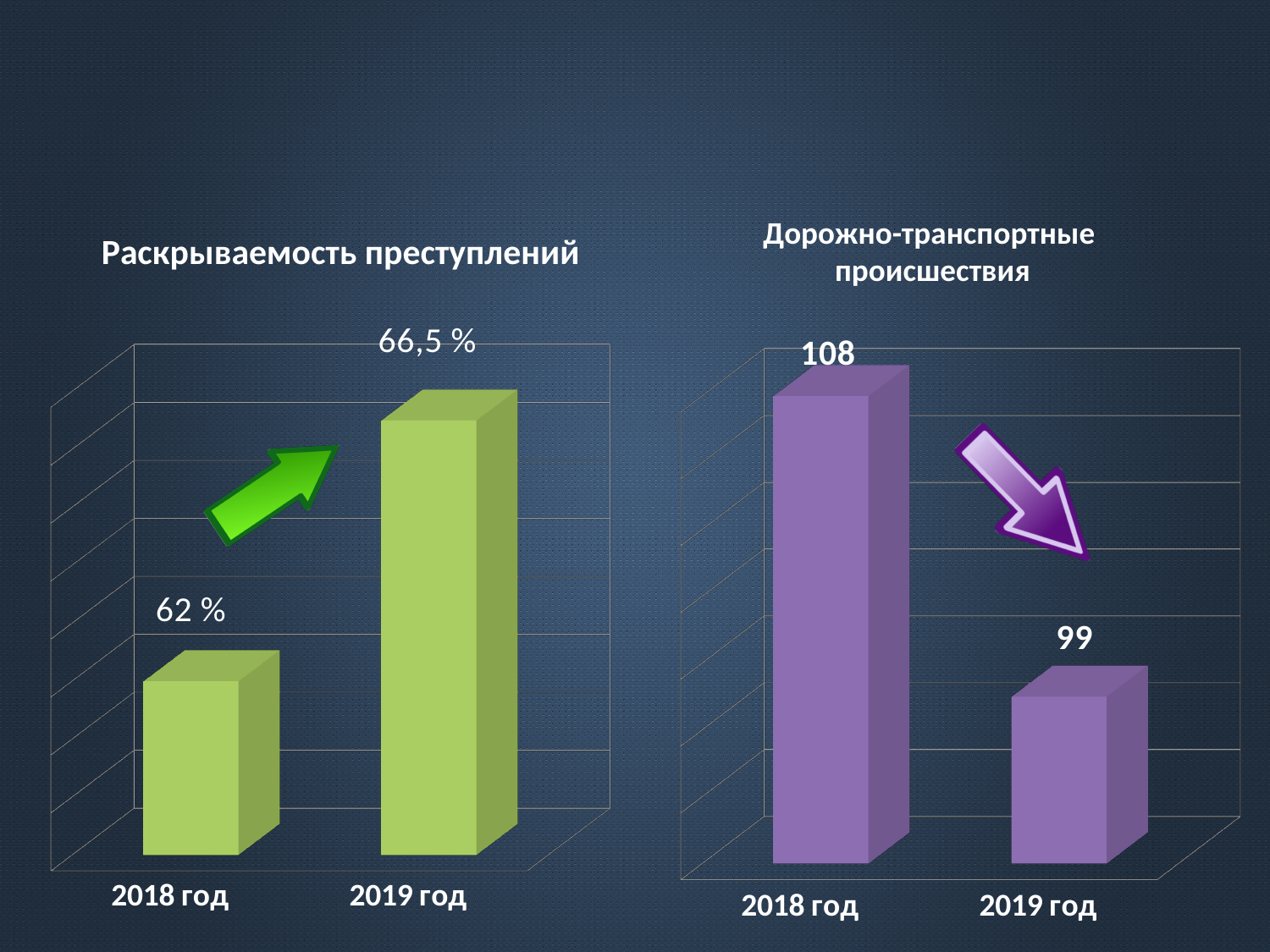
In the chart titled "Дорожно-транспортные происшествия", what is the value for 2018 год? 108 In the chart titled "Дорожно-транспортные происшествия", what is the value for 2019 год? 99 What kind of chart is the chart titled "Дорожно-транспортные происшествия"? bar chart In the chart titled "Дорожно-транспортные происшествия", is the value for 2018 год larger or smaller than the value for 2019 год? larger How many categories are shown in the chart titled "Раскрываемость преступлений"? 2 In the chart titled "Раскрываемость преступлений", what is the value for 2018 год? 62 % In the chart titled "Дорожно-транспортные происшествия", what is the difference between the 2018 год and 2019 год values? 9 In the chart titled "Дорожно-транспортные происшествия", which year has the lower value? 2019 год In the chart titled "Дорожно-транспортные происшествия", do the values rise or fall from 2018 год to 2019 год? fall In the chart titled "Раскрываемость преступлений", by how many percentage points does the 2019 год value exceed the 2018 год value? 4,5 In the chart titled "Раскрываемость преступлений", what is the value for 2019 год? 66,5 % In the chart titled "Раскрываемость преступлений", which year has the higher value? 2019 год